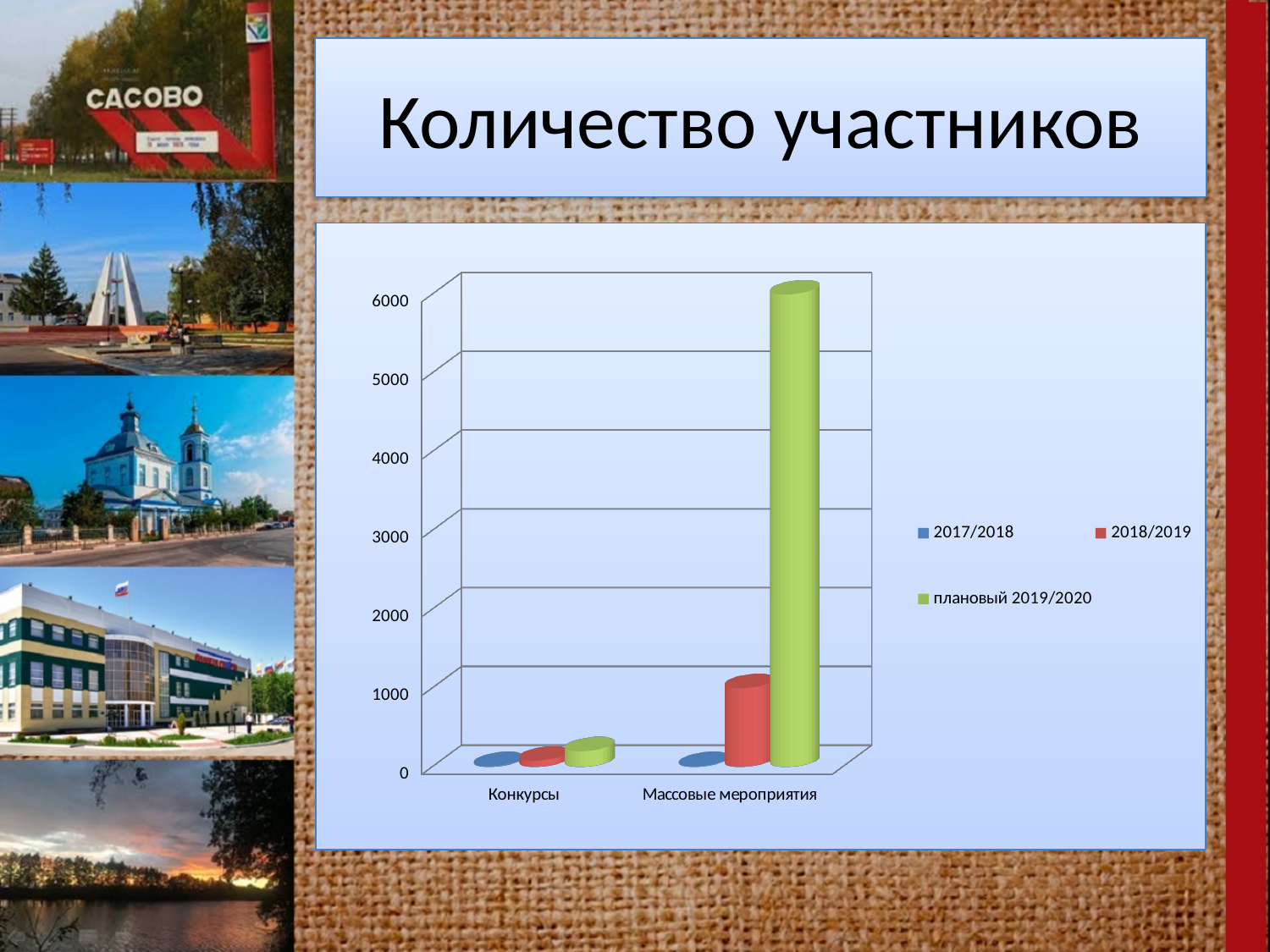
Is the value of плановый 2019/2020 for Массовые мероприятия greater or less than 5000? greater What kind of chart is shown on the slide? bar chart For Массовые мероприятия, which is larger: 2018/2019 or плановый 2019/2020? плановый 2019/2020 Which series has the highest value for Массовые мероприятия? плановый 2019/2020 How many series does the legend list? 3 Is the value of плановый 2019/2020 for Конкурсы greater or less than 1000? less How many categories are shown on the x axis? 2 Is the value of 2018/2019 for Массовые мероприятия greater or less than 2000? less Which series is shown in green in the legend? плановый 2019/2020 Which is larger for плановый 2019/2020: Конкурсы or Массовые мероприятия? Массовые мероприятия Which series has the lowest value for Массовые мероприятия? 2017/2018 What is the title of the chart? Количество участников